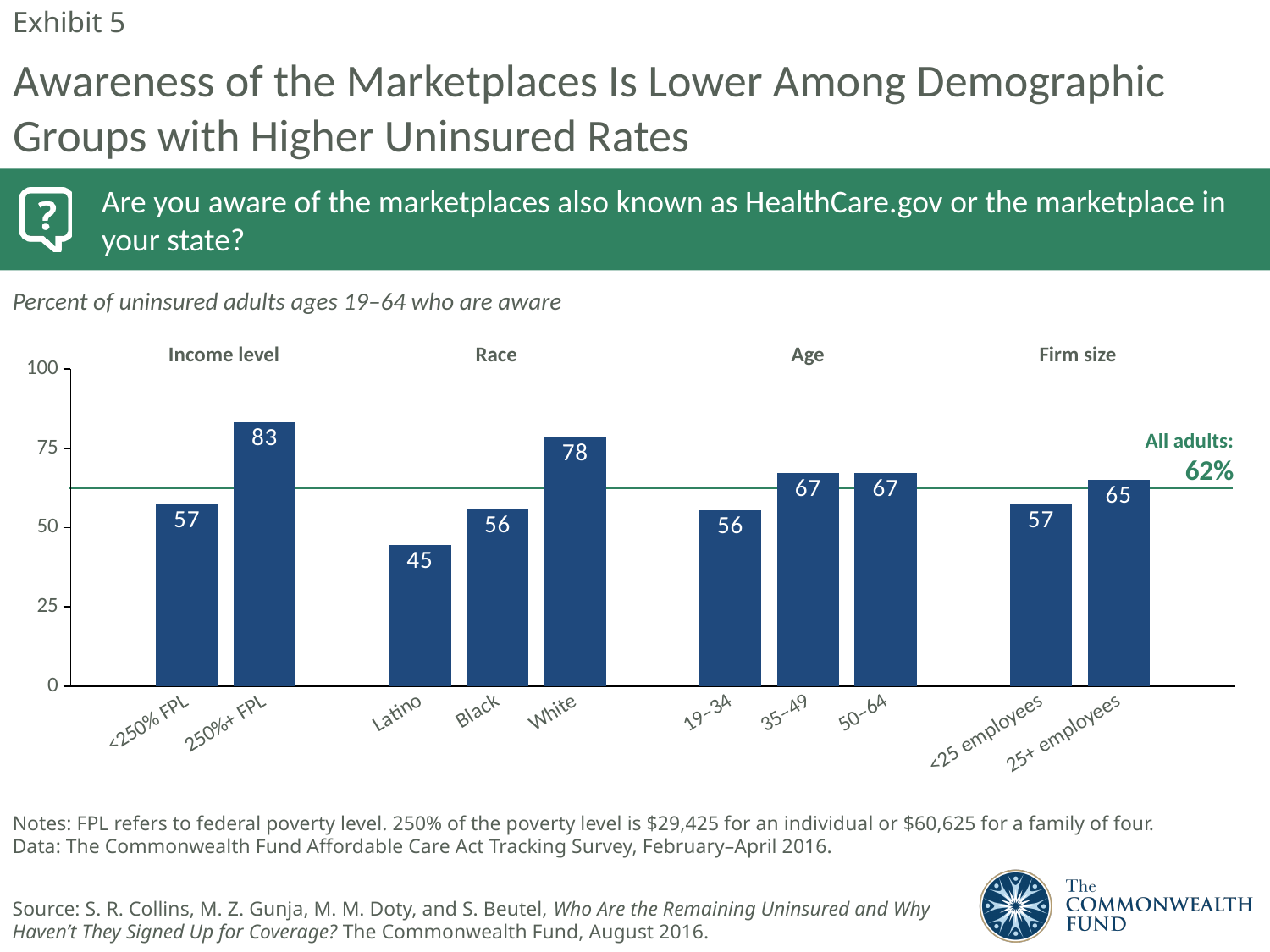
What is the value for adults ages 19–34? 56 What is the difference between the values for 250%+ FPL and <250% FPL? 26 How many bars are plotted on the chart? 10 How many demographic groupings are labeled above the bars? 4 What is the value for adults at firms with 25+ employees? 65 Which is larger, the value for Black adults or for White adults? White What is the value for White adults? 78 What is the awareness rate for all adults shown by the horizontal line? 62% Which category has the highest awareness? 250%+ FPL What kind of chart is shown? Bar chart What percent of uninsured adults with income below 250% FPL are aware of the marketplaces? 57 Which category has the lowest awareness? Latino